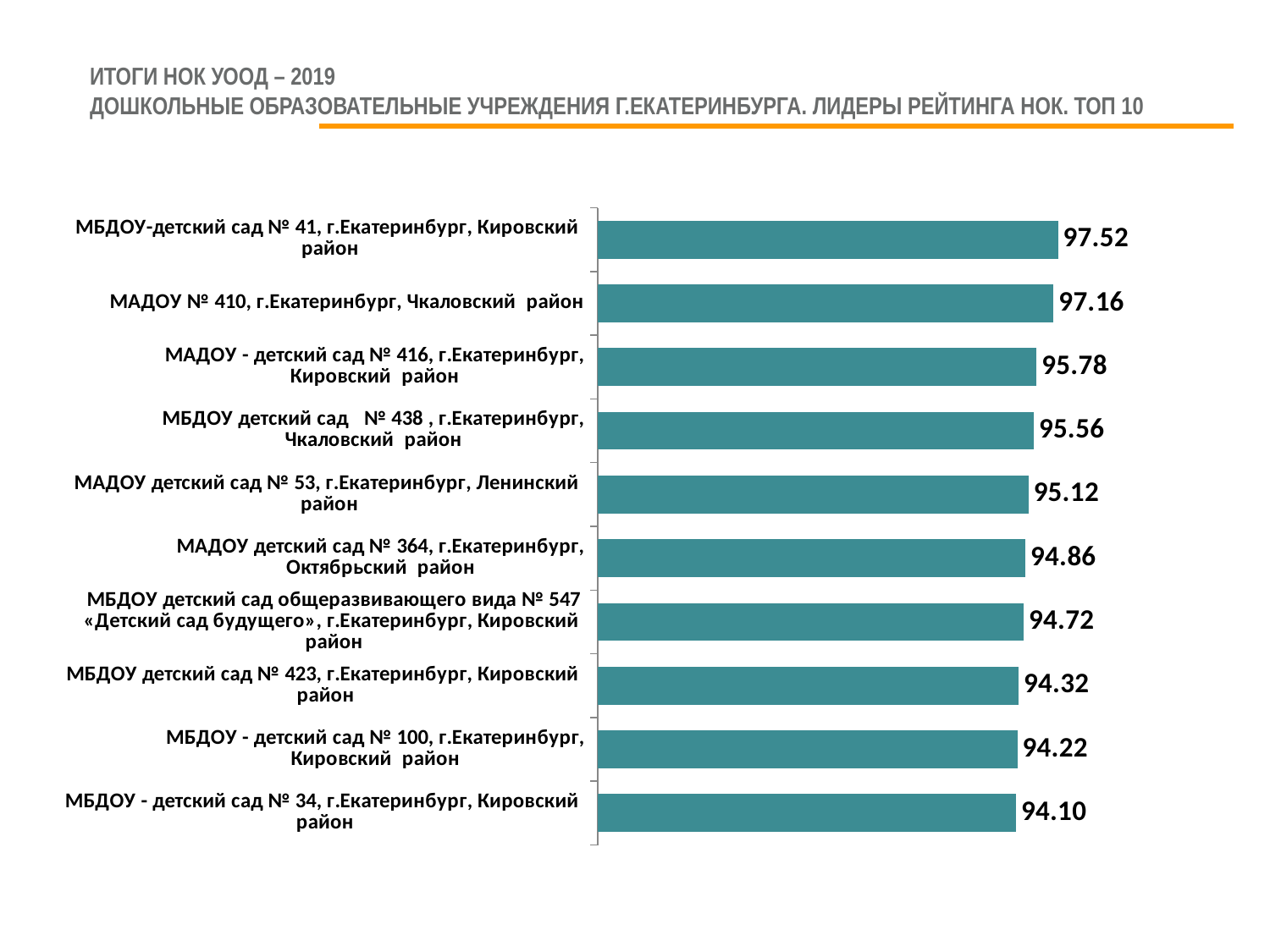
What kind of chart is shown on the slide? Bar chart Which category has the highest value? МБДОУ-детский сад № 41, г.Екатеринбург, Кировский район Which category has the lowest value? МБДОУ - детский сад № 34, г.Екатеринбург, Кировский район Which has a larger value: МАДОУ детский сад № 364, Октябрьский район or МБДОУ детский сад № 423, Кировский район? МАДОУ детский сад № 364, Октябрьский район What is the difference between the values for МАДОУ - детский сад № 416 and МБДОУ детский сад № 438? 0.22 What is the value for МАДОУ № 410, г.Екатеринбург, Чкаловский район? 97.16 What is the value for МБДОУ-детский сад № 41, г.Екатеринбург, Кировский район? 97.52 What colour are the bars in the chart? Teal How many categories are shown in the chart? 10 What is the difference between the values for МБДОУ-детский сад № 41 and МБДОУ - детский сад № 34? 3.42 What is the value for МБДОУ - детский сад № 34, г.Екатеринбург, Кировский район? 94.10 What is the value for МАДОУ детский сад № 53, г.Екатеринбург, Ленинский район? 95.12